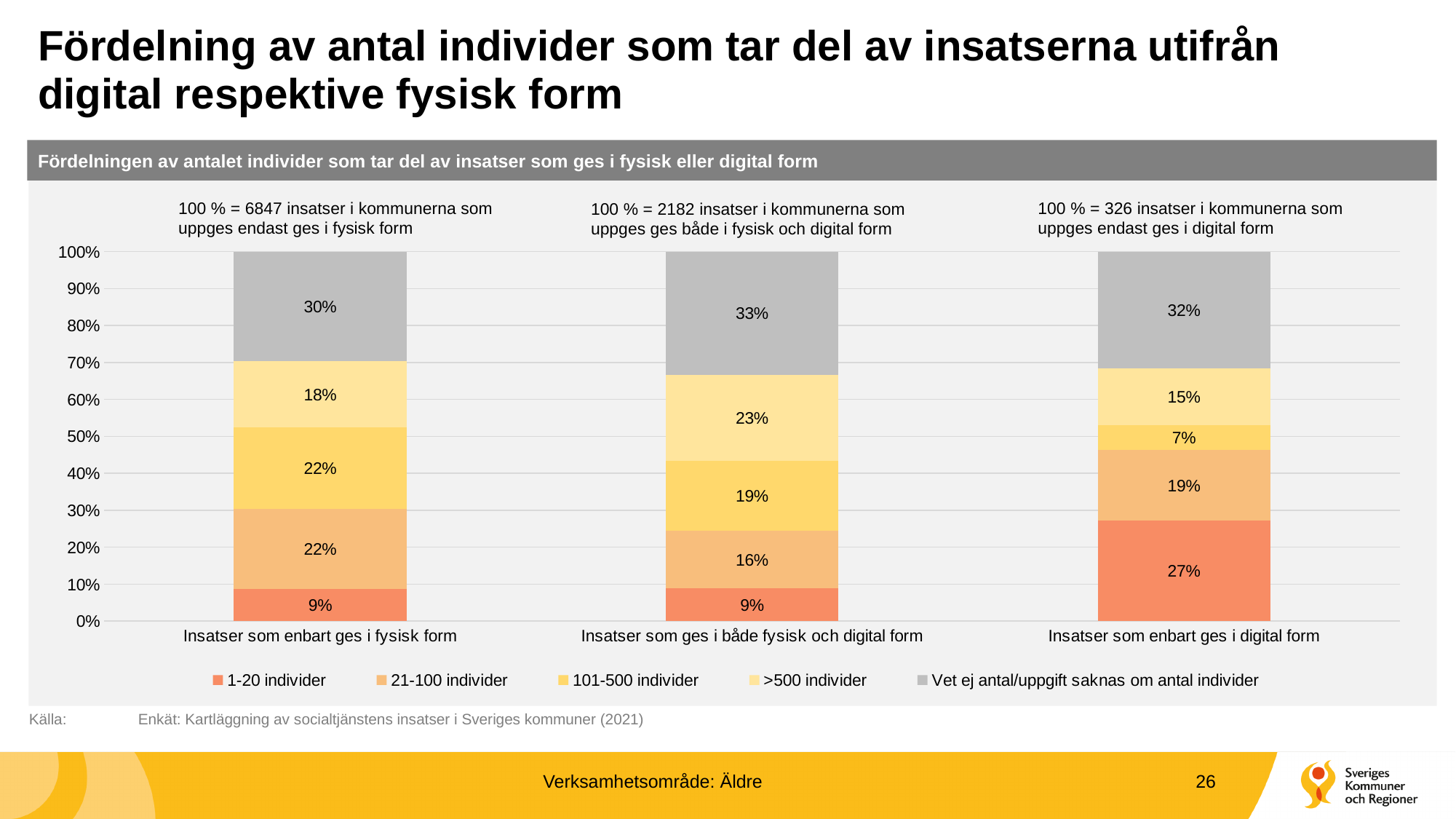
Which category has the highest share of '1-20 individer'? Insatser som enbart ges i digital form Which has a larger '>500 individer' share: 'Insatser som ges i både fysisk och digital form' or 'Insatser som enbart ges i fysisk form'? Insatser som ges i både fysisk och digital form What is the difference in the '101-500 individer' share between 'Insatser som enbart ges i fysisk form' and 'Insatser som enbart ges i digital form'? 15 percentage points Which category has the lowest share of '101-500 individer'? Insatser som enbart ges i digital form What is the share of '>500 individer' for 'Insatser som enbart ges i fysisk form'? 18% What kind of chart is shown on the slide? Stacked bar chart What is the share of 'Vet ej antal/uppgift saknas om antal individer' for 'Insatser som ges i både fysisk och digital form'? 33% How many categories are shown on the x axis? 3 According to the note above the first bar, how many insatser does 100 % correspond to for 'Insatser som enbart ges i fysisk form'? 6847 What is the share of '1-20 individer' for 'Insatser som enbart ges i digital form'? 27% What is the share of '21-100 individer' for 'Insatser som ges i både fysisk och digital form'? 16% How many series does the legend list? 5